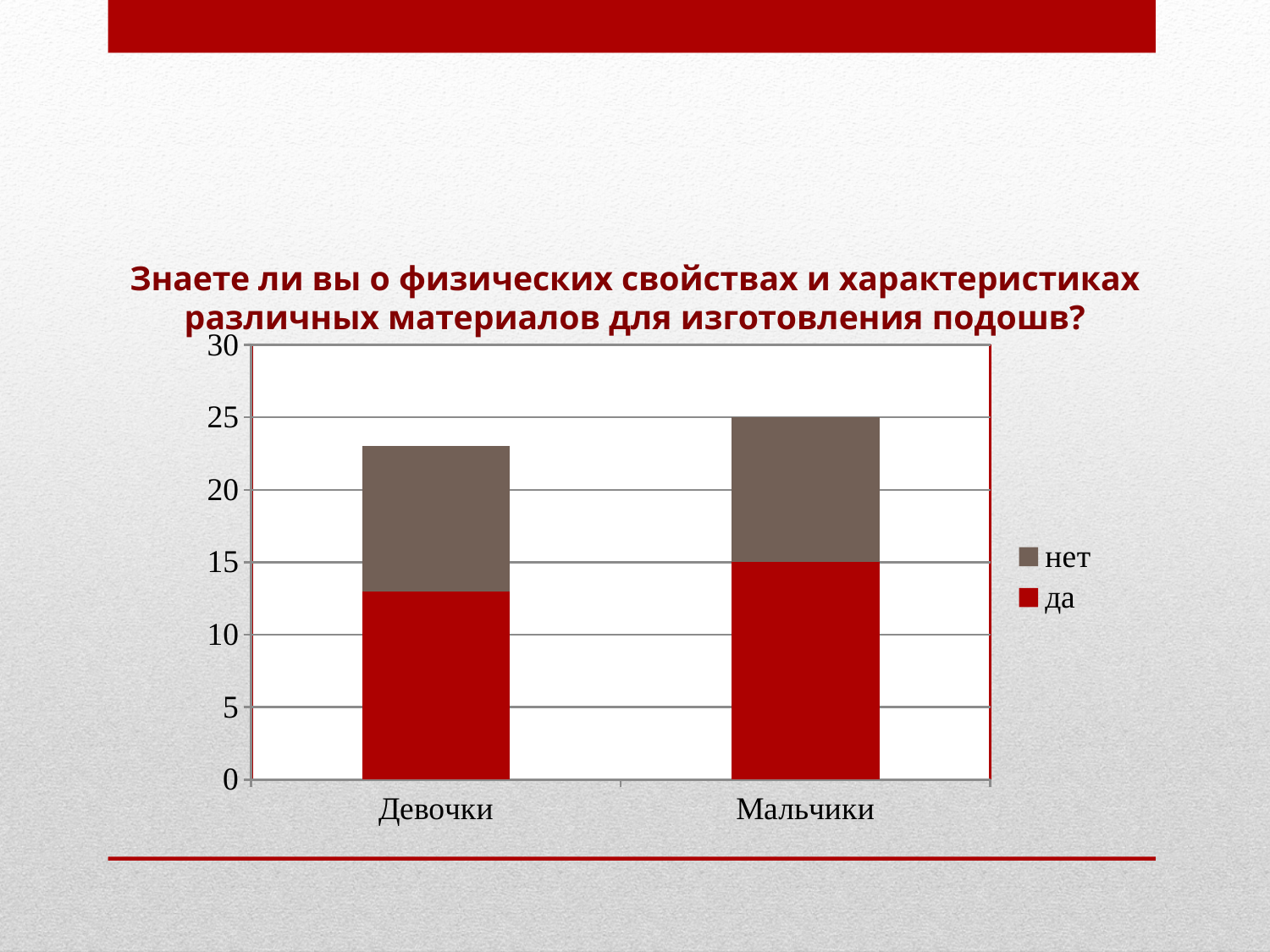
Which series is shown in red in the chart? да Which category has the taller stacked bar overall, Девочки or Мальчики? Мальчики Is the value of the "да" series for Девочки greater or less than 15? less What kind of chart is shown on the slide? bar chart What is the total height of the stacked bar for Мальчики? 25 What are the two entries listed in the chart legend? нет, да How many series does the chart legend list? 2 How many categories are shown on the x axis of the chart? 2 Is the total height of the stacked bar for Девочки greater or less than 20? greater Which category has the larger "да" value, Девочки or Мальчики? Мальчики What is the value of the "да" series for Мальчики? 15 Is the total height of the stacked bar for Девочки greater or less than 25? less